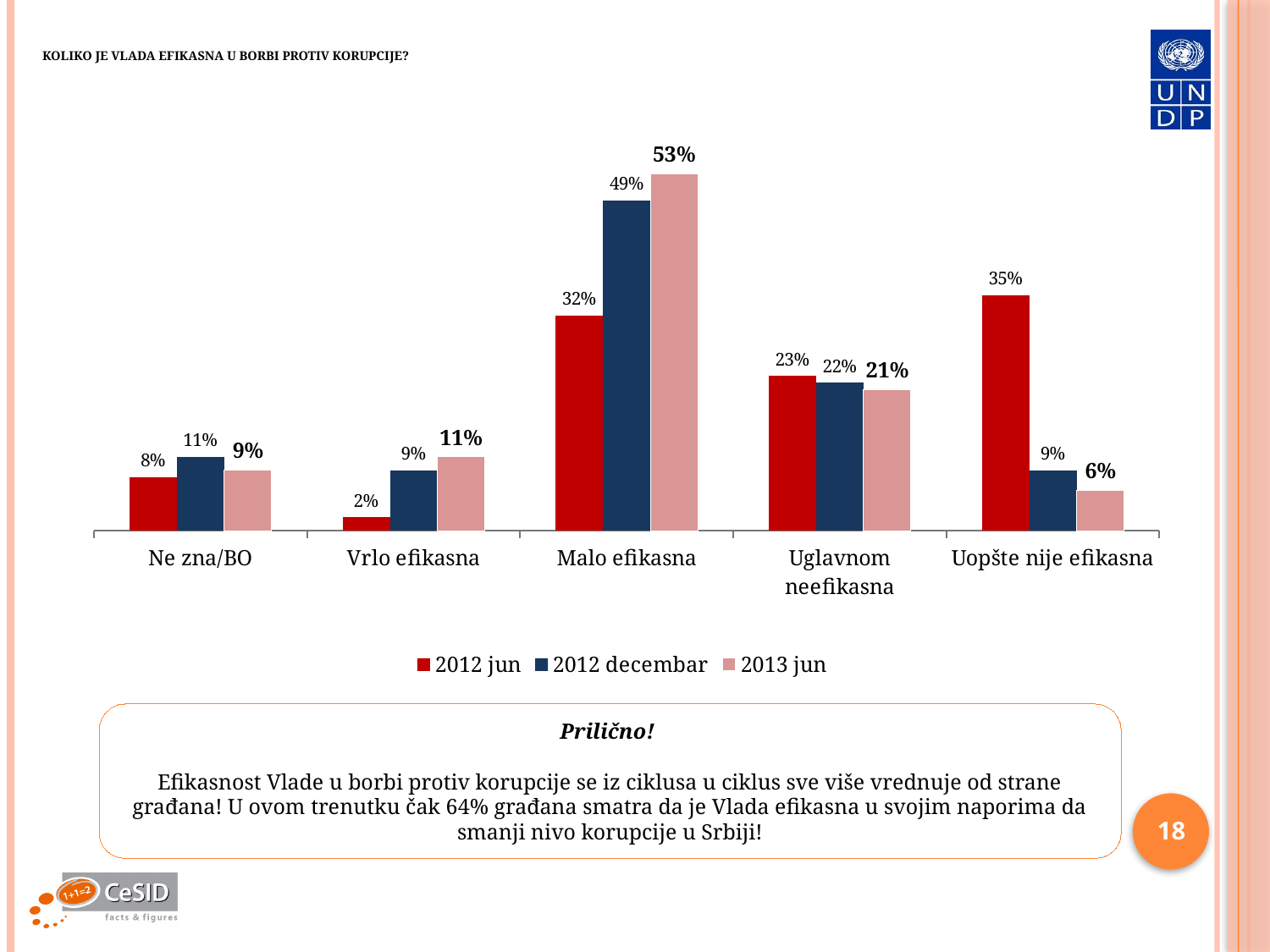
What is the title of the chart? KOLIKO JE VLADA EFIKASNA U BORBI PROTIV KORUPCIJE? What is the value for "Vrlo efikasna" in the 2012 decembar series? 9% How many series does the legend list? 3 What is the value for "Uopšte nije efikasna" in the 2012 jun series? 35% What kind of chart is shown on the slide? Bar chart Which is larger for "Uopšte nije efikasna": the 2012 jun value or the 2013 jun value? 2012 jun What is the difference between the 2013 jun and 2012 jun values for "Malo efikasna"? 21% Which category has the highest value in the 2012 decembar series? Malo efikasna What is the value for "Malo efikasna" in the 2013 jun series? 53% How many categories are shown on the x axis? 5 Which category has the lowest value in the 2012 jun series? Vrlo efikasna Do the values for "Uopšte nije efikasna" rise or fall from 2012 jun to 2013 jun? Fall